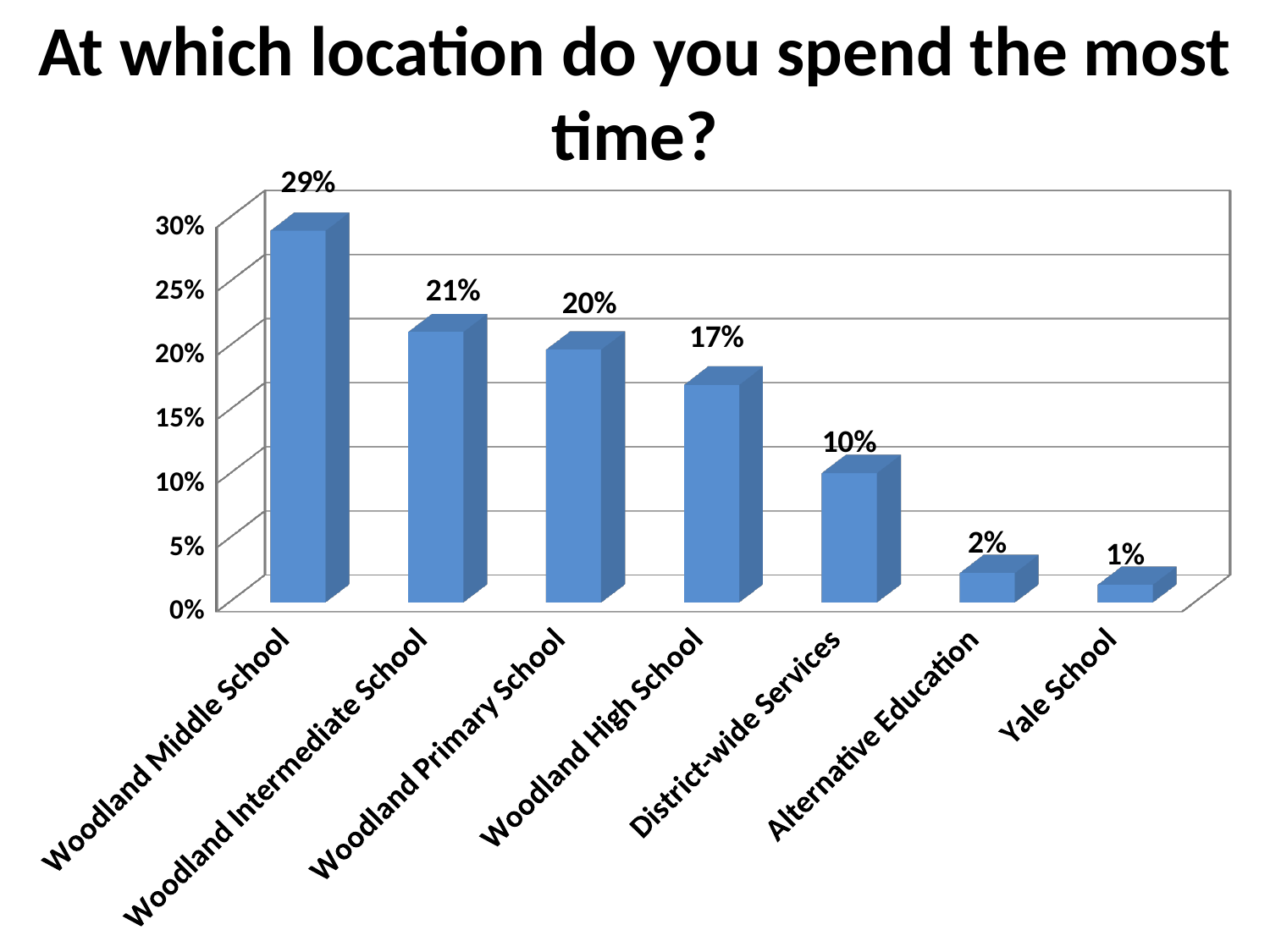
Which is larger, the value for Woodland Intermediate School or Woodland Primary School? Woodland Intermediate School What is the value shown for District-wide Services? 10% What is the difference between the values for Woodland Middle School and Woodland Intermediate School? 8% How many locations are shown on the chart? 7 Do the values rise or fall from left to right across the locations? Fall What kind of chart is shown on the slide? Bar chart What is the difference between the values for Woodland Primary School and District-wide Services? 10% What percentage of respondents spend the most time at Woodland Middle School? 29% Which location has the lowest percentage? Yale School Which location has the highest percentage? Woodland Middle School What is the value shown for Woodland High School? 17% Is the value for Woodland High School greater or less than 15%? greater